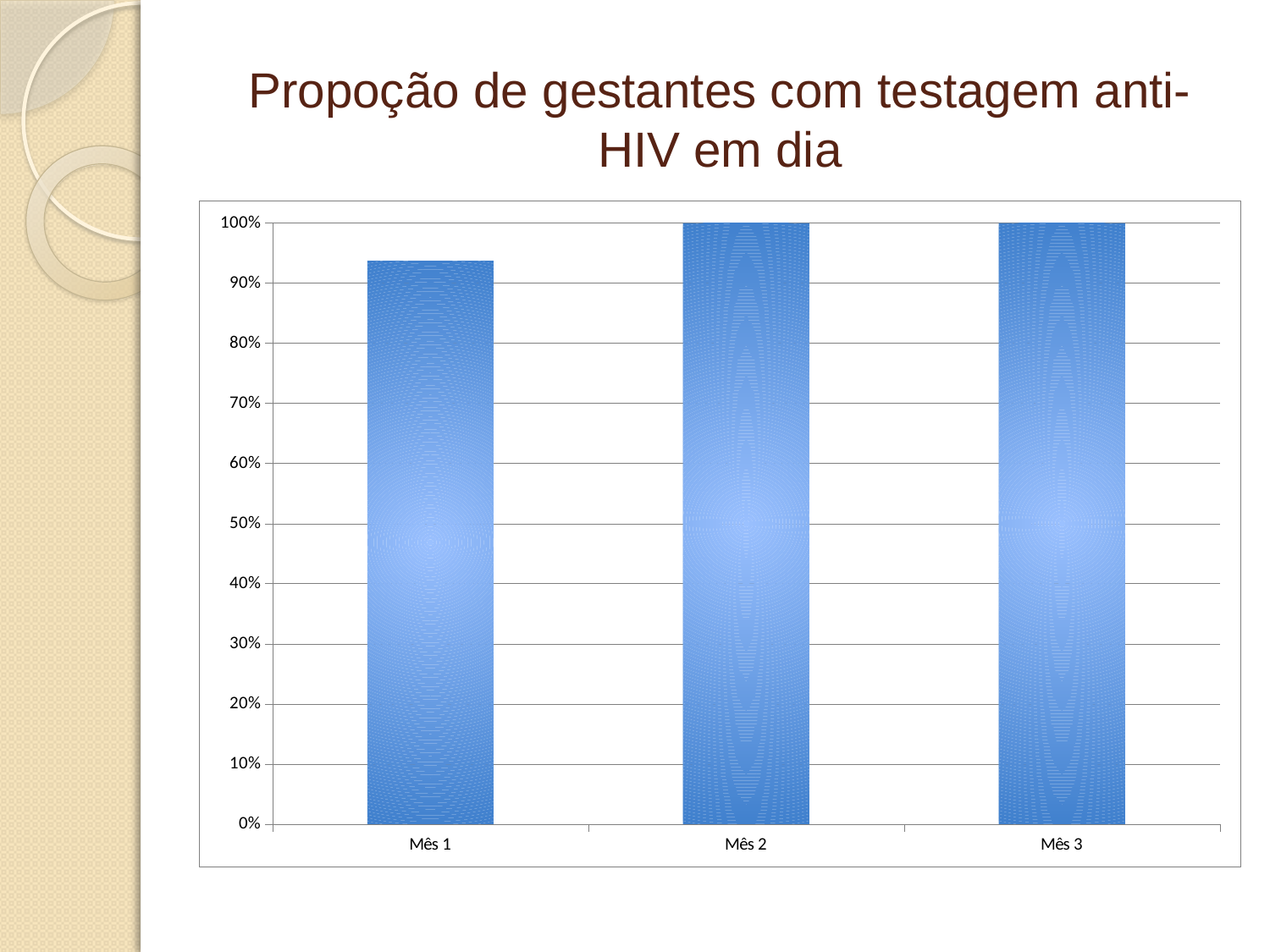
How many categories (months) are plotted on the chart? 3 Is the value for Mês 1 greater or less than 100%? less Which is larger, the value for Mês 3 or the value for Mês 1? Mês 3 What is the title of the slide? Propoção de gestantes com testagem anti-HIV em dia Which month has the lowest value? Mês 1 Do the values rise or fall from Mês 1 to Mês 3? rise Is the value for Mês 1 greater or less than 90%? greater What is the value for Mês 3? 100% What kind of chart is shown on the slide? bar chart What is the highest value shown on the vertical axis? 100% Which is larger, the value for Mês 1 or the value for Mês 2? Mês 2